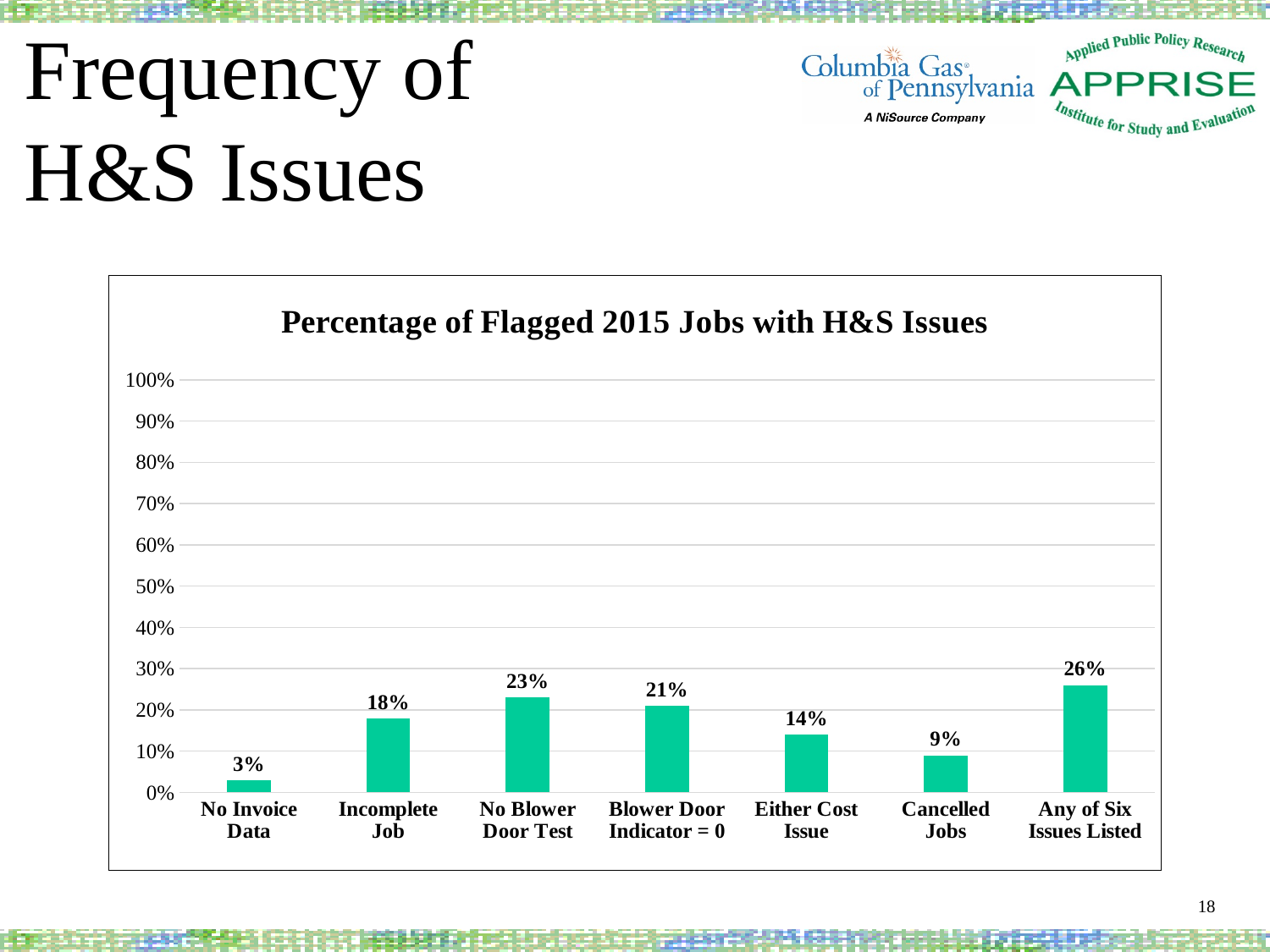
Which category has the highest value? Any of Six Issues Listed Which category has the lowest value? No Invoice Data Is the value for Any of Six Issues Listed greater or less than 20%? greater How many categories are shown on the x axis? 7 What is the difference between the values for No Blower Door Test and Either Cost Issue? 9% Which is larger, the value for Incomplete Job or the value for Cancelled Jobs? Incomplete Job What is the value for Cancelled Jobs? 9% What is the value for Blower Door Indicator = 0? 21% What kind of chart is shown? bar chart What is the value for No Invoice Data? 3% What is the highest value shown on the y axis? 100% What is the title of the chart? Percentage of Flagged 2015 Jobs with H&S Issues